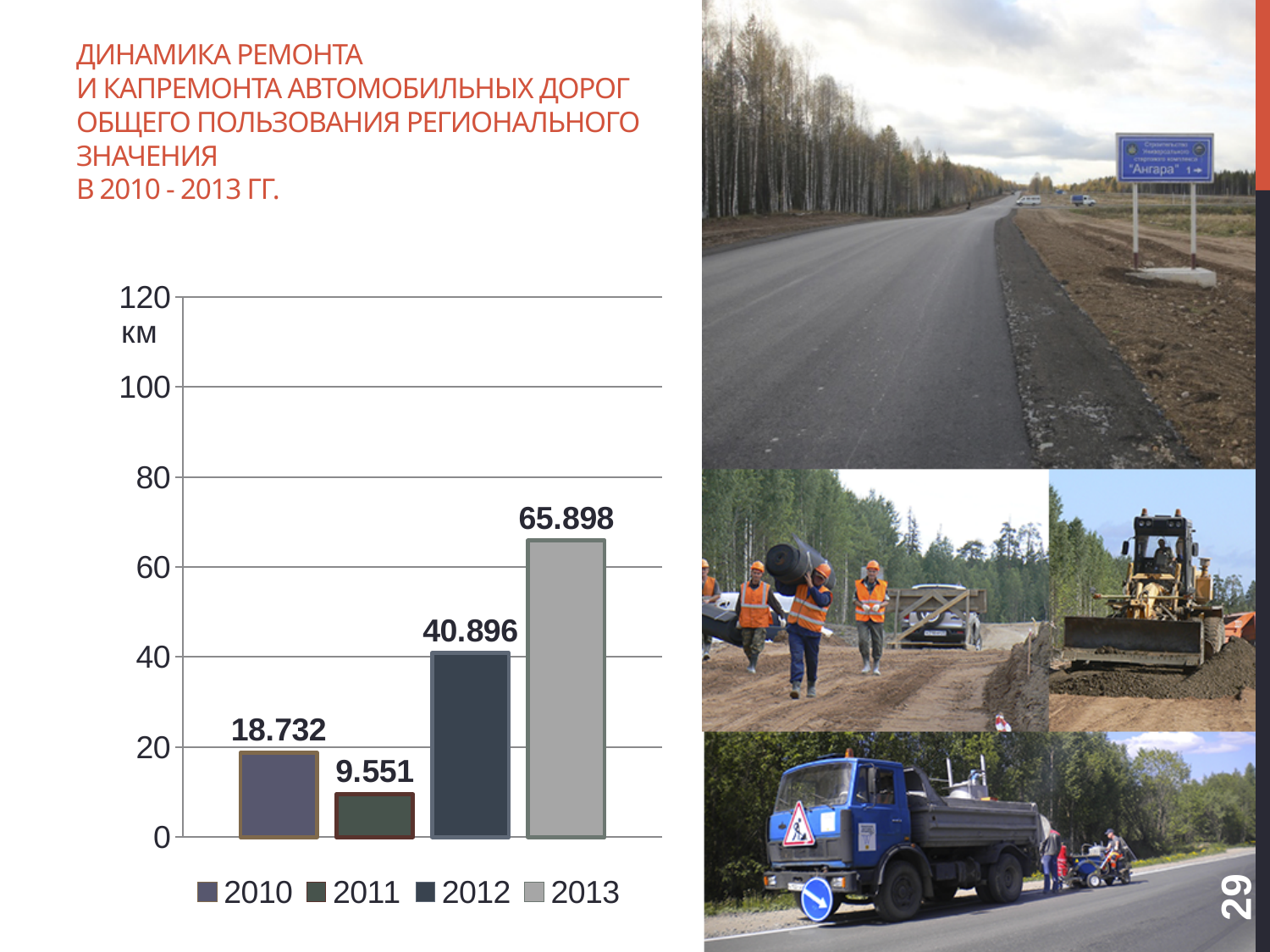
How many bars are plotted on the chart? 4 What value is shown for 2011 on the chart? 9.551 What value is shown for 2013 on the chart? 65.898 What unit is shown on the vertical axis of the chart? км What is the difference between the values for 2010 and 2011? 9.181 Which year has the lowest value on the chart? 2011 Is the value for 2012 greater or less than 60? less What kind of chart is shown on the slide? bar chart Which is larger, the value for 2012 or the value for 2010? 2012 Which year has the highest value on the chart? 2013 What is the difference between the values for 2013 and 2012? 25.002 What value is shown for 2010 on the chart? 18.732